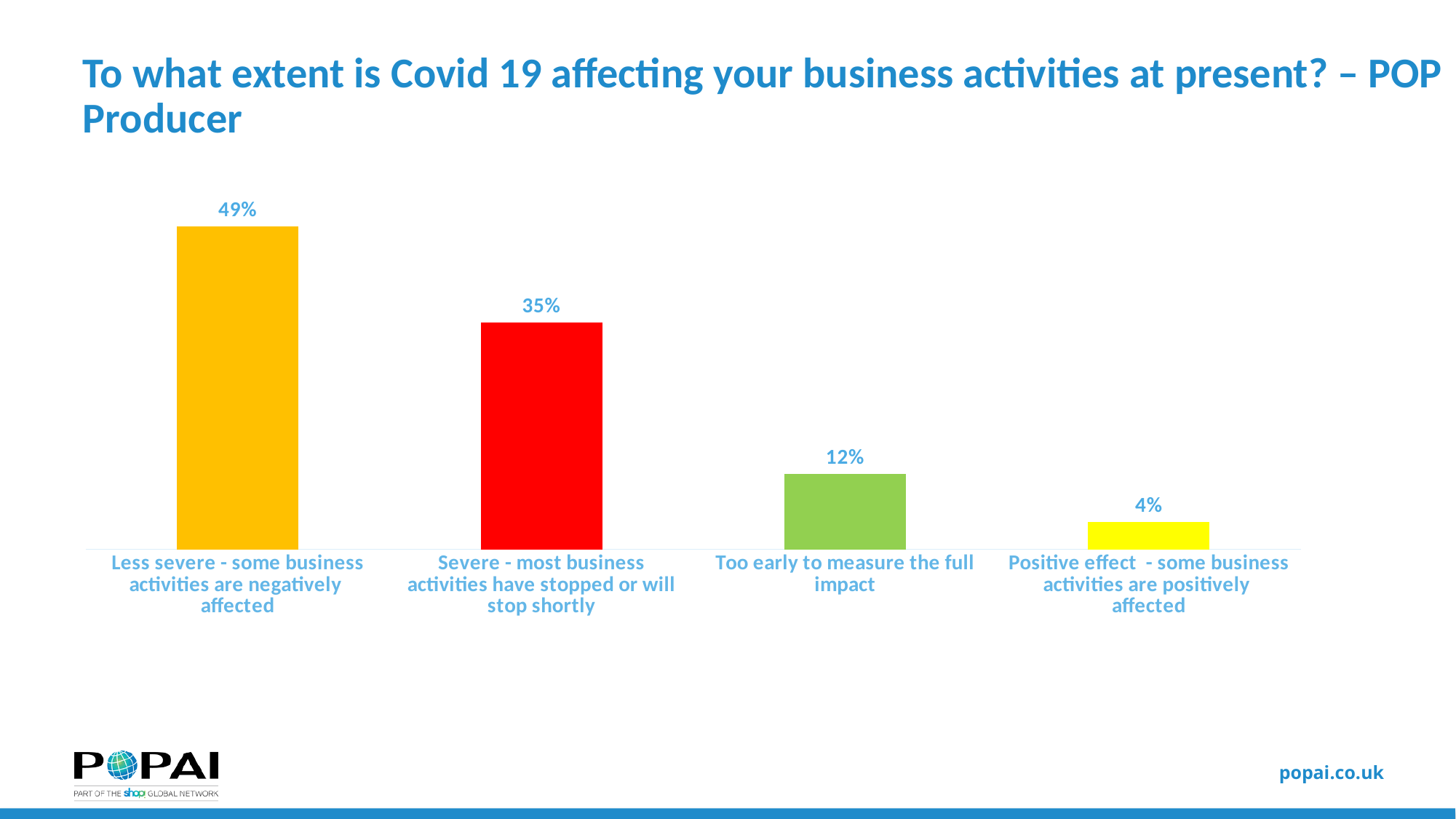
What is the difference between 'Too early to measure the full impact' and 'Positive effect'? 8% Which is larger: the value for 'Severe' or the value for 'Too early to measure the full impact'? Severe - most business activities have stopped or will stop shortly Which category has the lowest value? Positive effect - some business activities are positively affected How many categories are shown in the chart? 4 What value is shown for 'Positive effect - some business activities are positively affected'? 4% What percentage is shown for 'Too early to measure the full impact'? 12% What value is shown for 'Severe - most business activities have stopped or will stop shortly'? 35% What is the difference between the 'Less severe' and 'Severe' percentages? 14% What percentage of respondents said the effect was 'Less severe - some business activities are negatively affected'? 49% What colour is the bar for 'Severe - most business activities have stopped or will stop shortly'? Red Which category has the highest value? Less severe - some business activities are negatively affected What kind of chart is shown on the slide? Bar chart